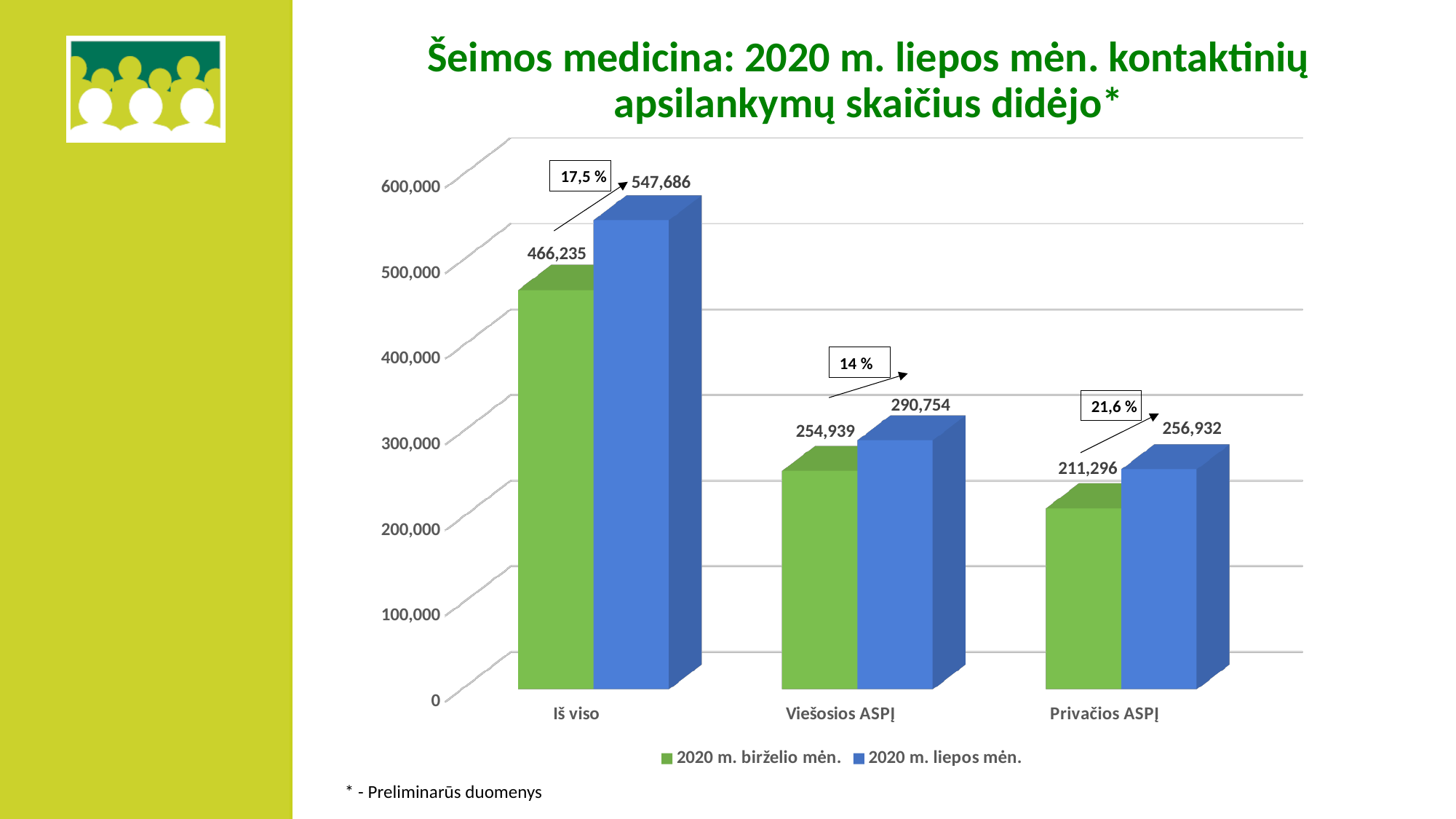
What is the difference between the 2020 m. liepos mėn. and 2020 m. birželio mėn. values for Privačios ASPĮ? 45,636 What is the difference between the 2020 m. liepos mėn. and 2020 m. birželio mėn. values for Iš viso? 81,451 Which category has the lowest value in the 2020 m. birželio mėn. series? Privačios ASPĮ How many series does the legend list? 2 Which is larger for Viešosios ASPĮ: the 2020 m. birželio mėn. value or the 2020 m. liepos mėn. value? 2020 m. liepos mėn. What is the value for Iš viso in the 2020 m. liepos mėn. series? 547,686 What percentage change is annotated above the Privačios ASPĮ bars? 21,6 % What kind of chart is shown on the slide? Bar chart How many categories are shown on the x axis? 3 What is the value for Viešosios ASPĮ in the 2020 m. birželio mėn. series? 254,939 Which category has the highest value in the 2020 m. liepos mėn. series? Iš viso What is the value for Privačios ASPĮ in the 2020 m. liepos mėn. series? 256,932